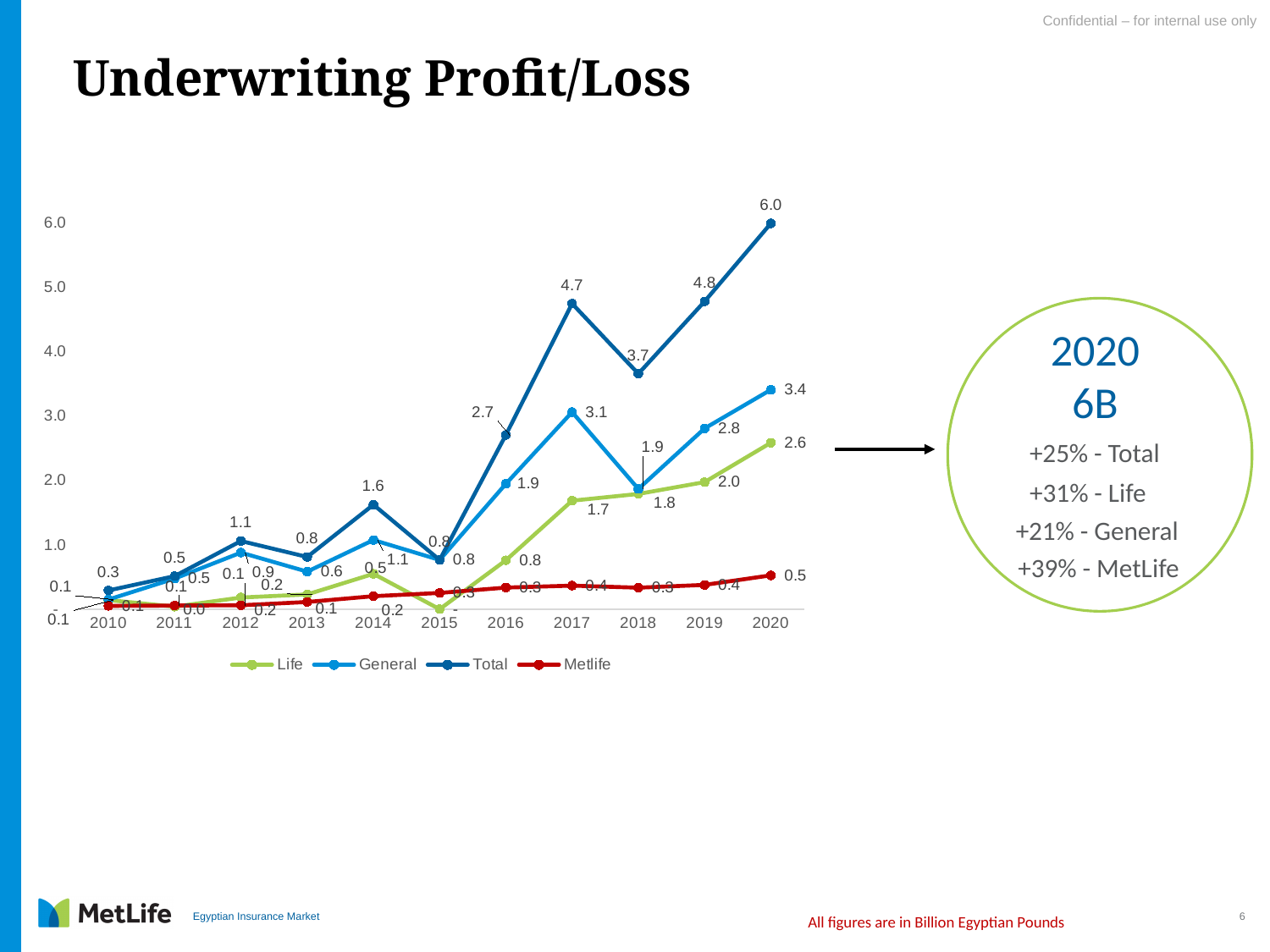
In which year does the Total series reach its highest value? 2020 How many years are shown on the x axis? 11 What is the General series value for 2020? 3.4 What is the difference between the Total values for 2020 and 2019? 1.2 How many series does the legend list? 4 Does the Total series rise or fall from 2018 to 2020? Rise Which year has the larger General value, 2017 or 2018? 2017 What kind of chart is shown on the slide? Line chart What is the Life series value for 2020? 2.6 What is the Total underwriting profit value for 2020? 6.0 What is the Total series value for 2017? 4.7 What is the Metlife series value for 2020? 0.5